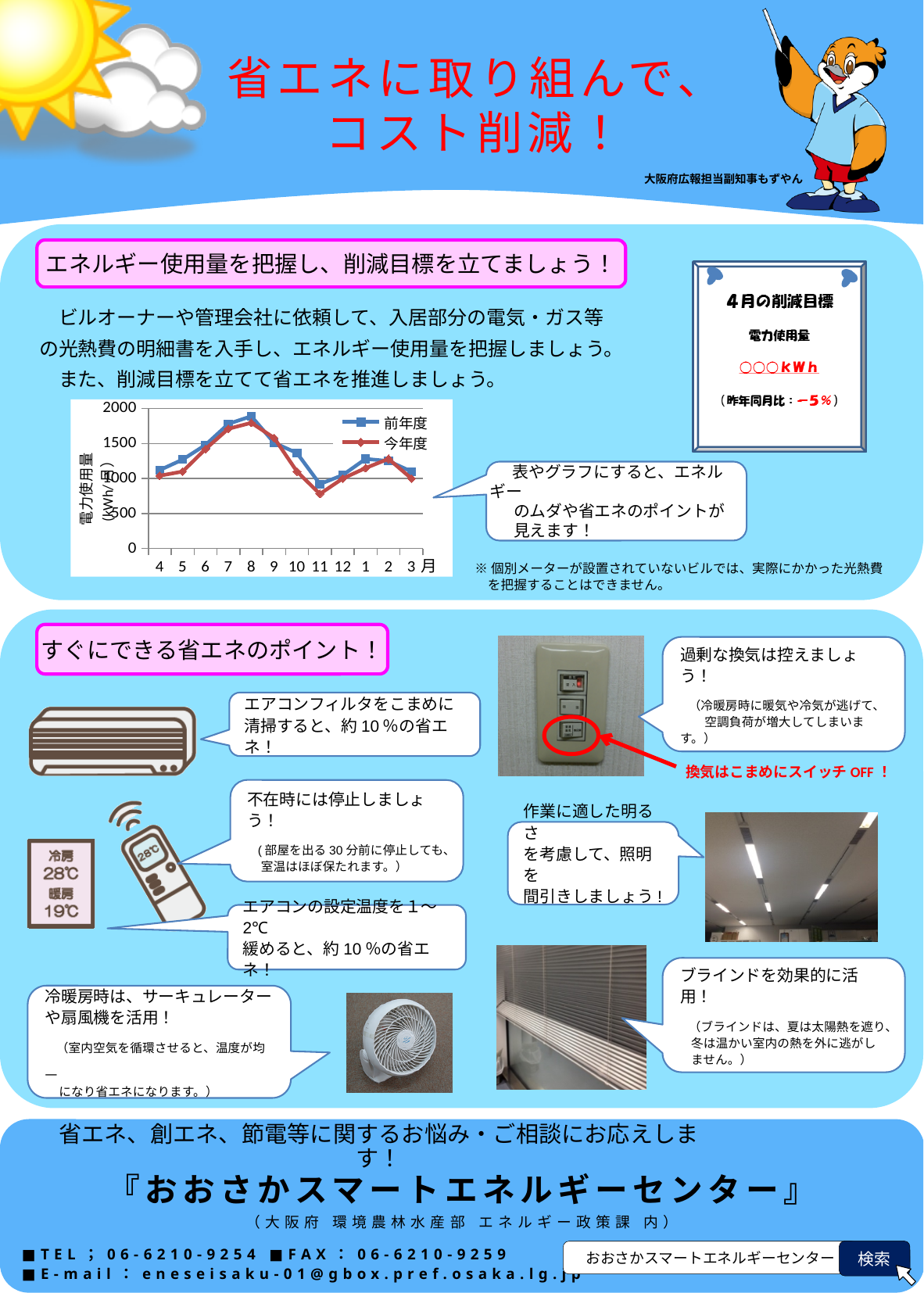
What is the label of the chart's y axis? 電力使用量（kWh/月） In which month does the 前年度 series reach its highest value? 8 How many months are plotted along the x axis of the chart? 12 What kind of chart is shown on the slide? line chart In which month does the 今年度 series reach its lowest value? 11 Is the 今年度 value for month 11 greater or less than 1000? less What are the two series named in the chart's legend? 前年度 and 今年度 In month 10, which series has the higher value, 前年度 or 今年度? 前年度 Is the 今年度 value for month 7 greater or less than 1500? greater Is the 前年度 value for month 8 greater or less than 1500? greater Do the 今年度 values rise or fall from month 4 to month 8? rise How many series does the chart's legend list? 2